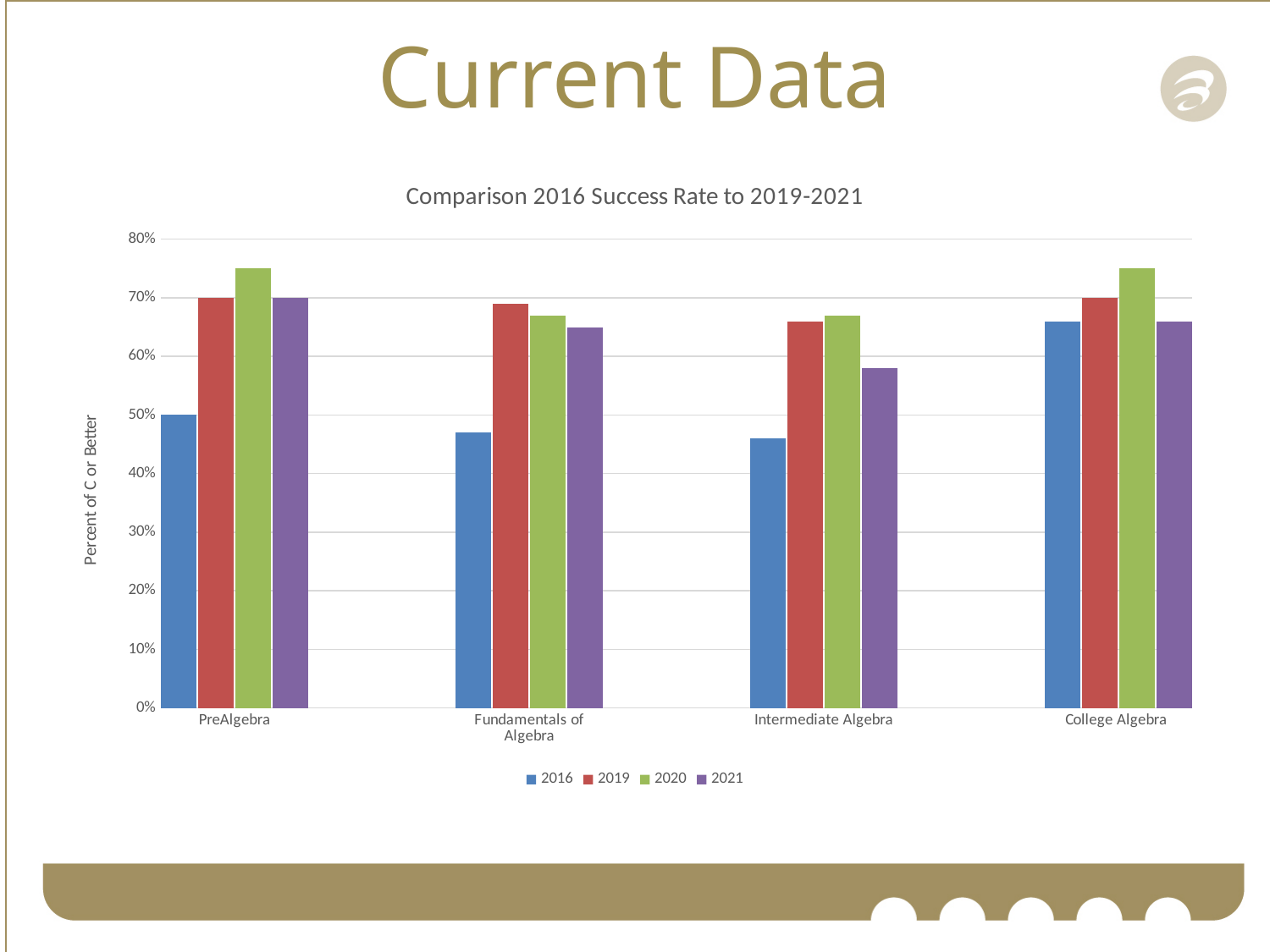
What type of chart is shown on the slide? Bar chart What is the 2016 success rate for PreAlgebra? 50% Is the 2021 value for Intermediate Algebra greater or less than 60%? less Which course has the highest 2016 success rate? College Algebra For Intermediate Algebra, which is larger: the 2019 value or the 2021 value? 2019 Is the 2016 value for Fundamentals of Algebra greater or less than 50%? less How many course categories are shown on the x axis? 4 What is the title of the chart? Comparison 2016 Success Rate to 2019-2021 What is the 2019 success rate for PreAlgebra? 70% Is the 2020 value for College Algebra greater or less than 70%? greater How many series does the legend list? 4 Which course has the lowest 2021 success rate? Intermediate Algebra